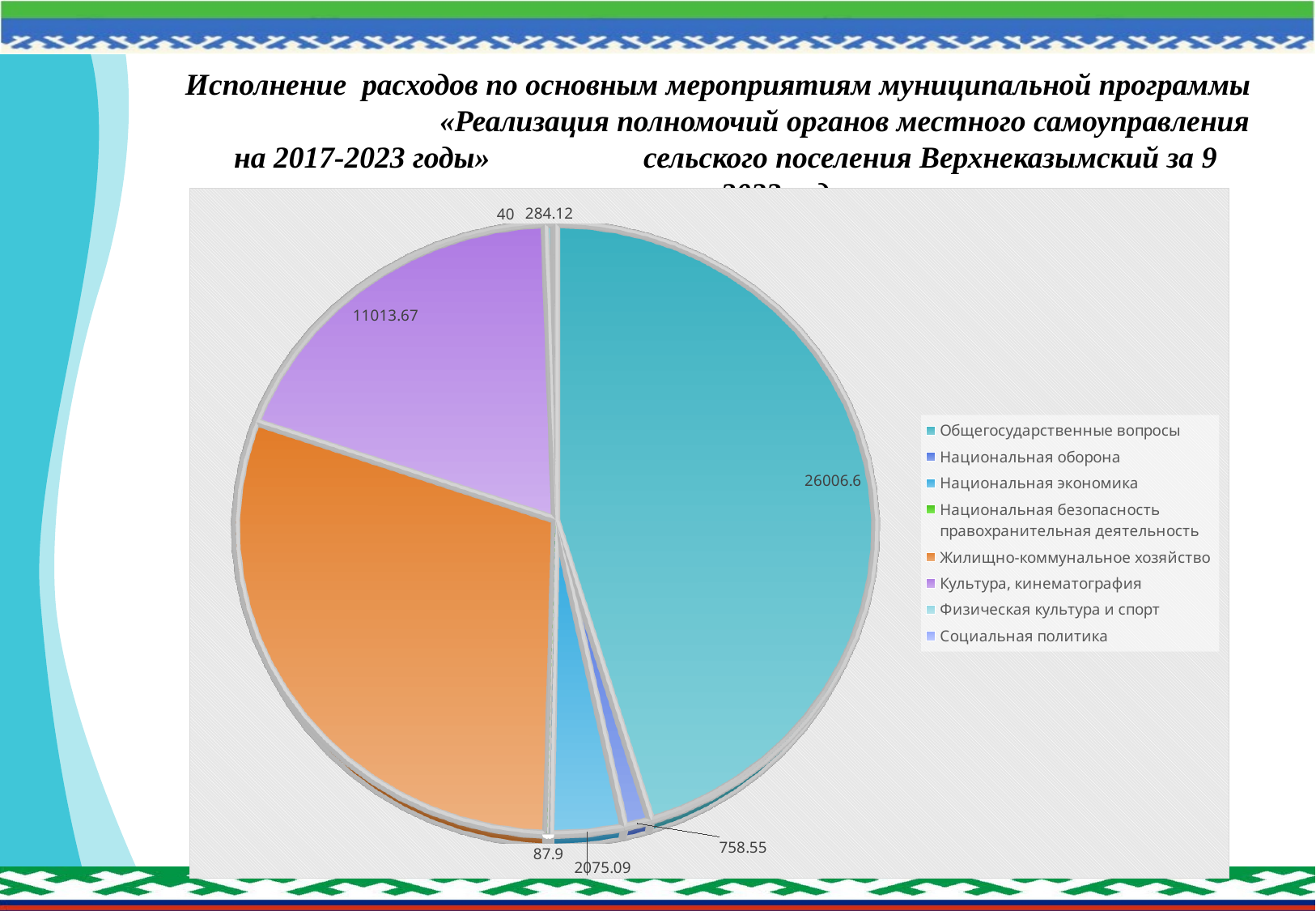
Which category has the smallest value in the pie chart? Социальная политика What is the value shown for Национальная оборона? 758.55 What colour is the slice for Жилищно-коммунальное хозяйство? orange How many categories does the legend of the pie chart list? 8 What is the difference between the values for Общегосударственные вопросы and Культура, кинематография? 14992.93 What is the value shown for Общегосударственные вопросы? 26006.6 Which category has the largest slice of the pie? Общегосударственные вопросы Which is larger: Культура, кинематография or Национальная экономика? Культура, кинематография What type of chart is shown on the slide? pie chart What is the value shown for Национальная экономика? 2075.09 What is the value shown for Социальная политика? 40 What is the value shown for Культура, кинематография? 11013.67